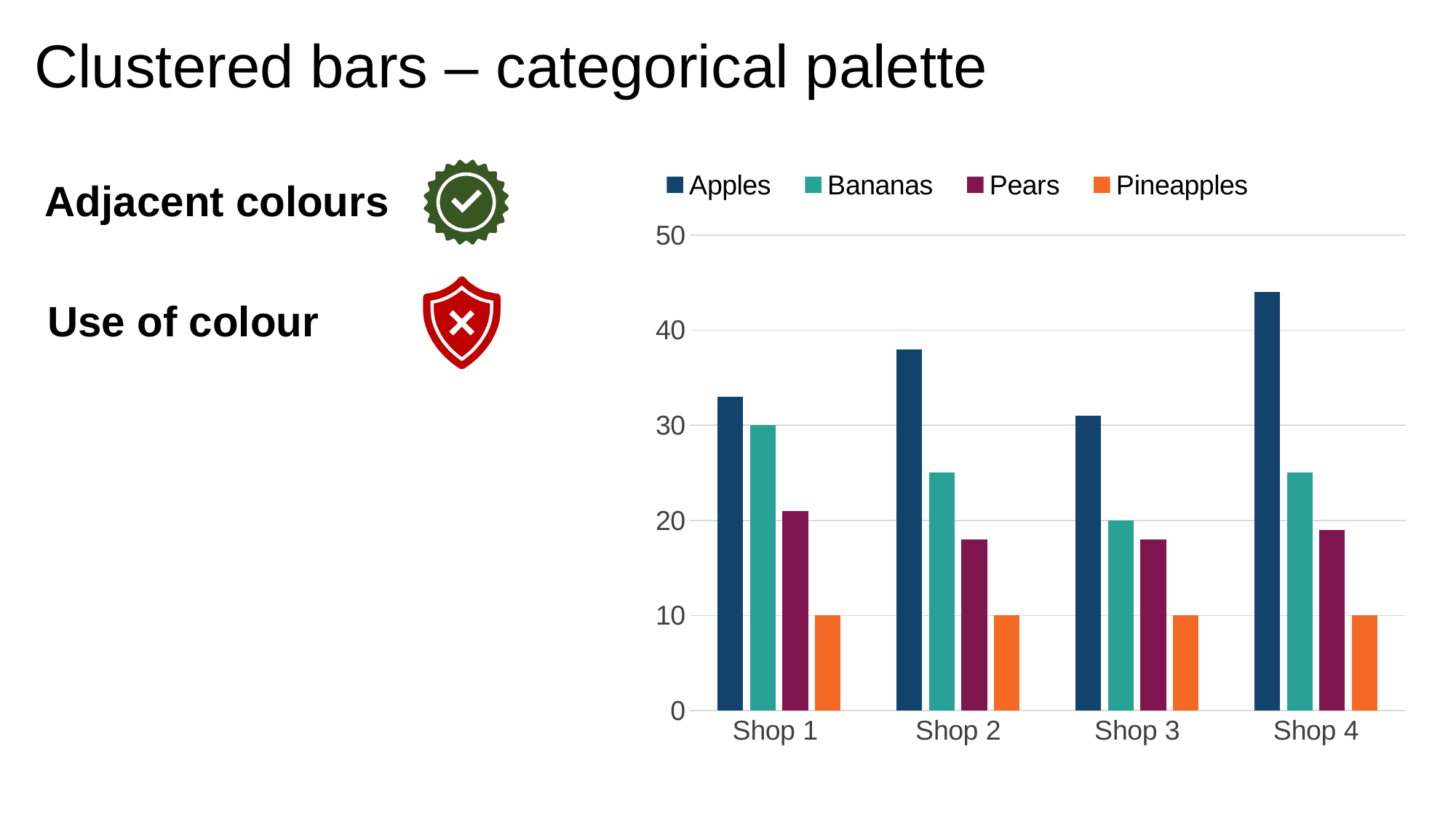
What is the value for Pineapples at Shop 2? 10 Is the value for Pears at Shop 2 greater or less than 20? less What is the value for Bananas at Shop 1? 30 How many series does the legend list? 4 Which is larger, Apples at Shop 2 or Apples at Shop 3? Apples at Shop 2 What kind of chart is shown on the slide? bar chart What is the value for Bananas at Shop 3? 20 How many shops are shown on the x axis? 4 Which series is shown in orange in the legend? Pineapples Which shop has the highest value for Apples? Shop 4 Is the value for Apples at Shop 4 greater or less than 40? greater Which series has the lowest value at Shop 1? Pineapples